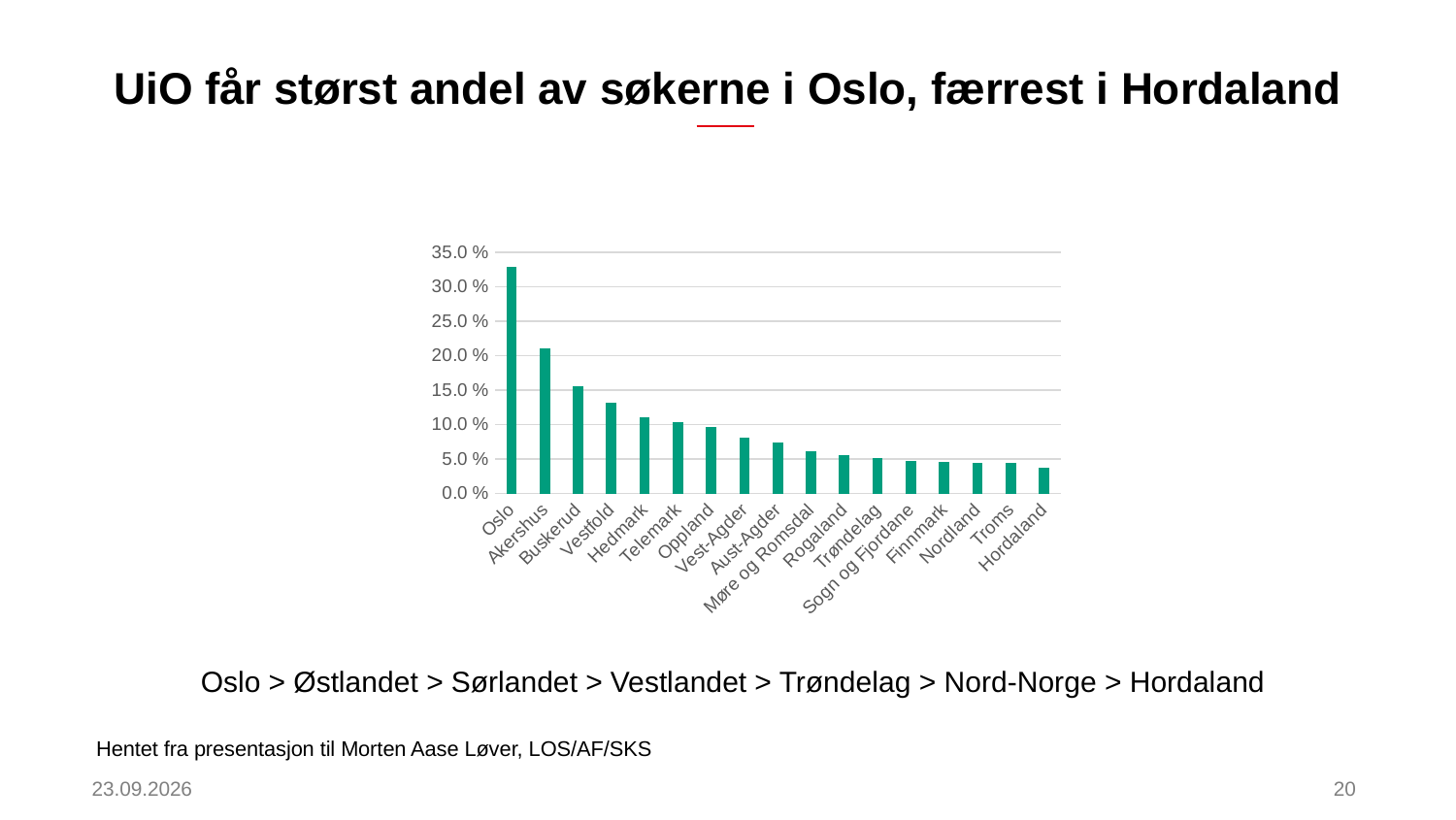
Is the value for Hordaland greater or less than 5.0 %? less Is the value for Vest-Agder greater or less than 10.0 %? less Which has a larger value, Buskerud or Vestfold? Buskerud Do the values rise or fall moving from left to right along the x axis? fall Which county has the lowest value in the chart? Hordaland What kind of chart is shown on the slide? bar chart How many counties (categories) are shown on the x axis of the chart? 17 Is the value for Oslo greater or less than 30.0 %? greater What is the title of the slide containing the chart? UiO får størst andel av søkerne i Oslo, færrest i Hordaland Which county has the highest value in the chart? Oslo Which has a larger value, Oslo or Akershus? Oslo